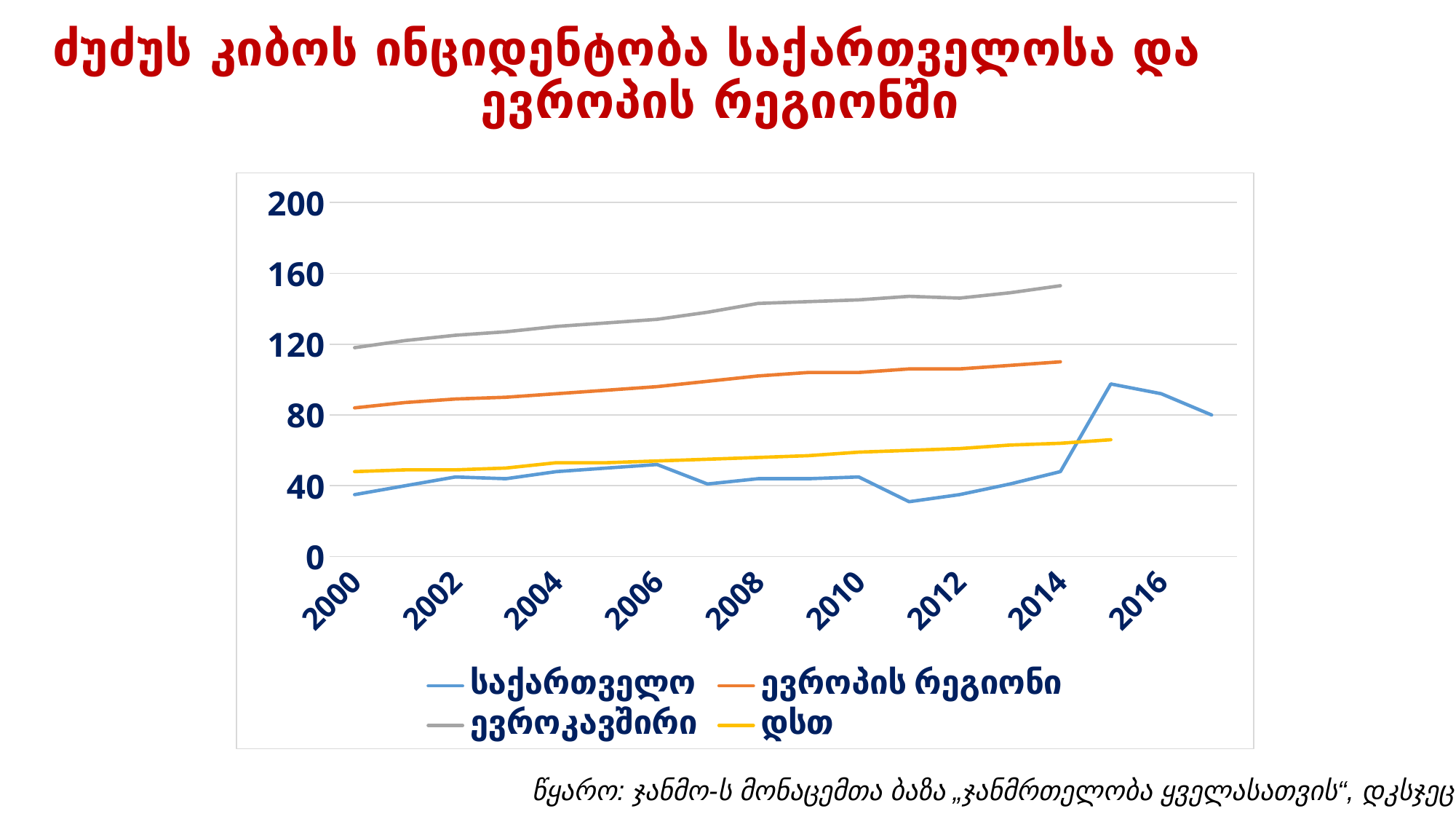
In 2010, which is higher: ევროკავშირი or ევროპის რეგიონი? ევროკავშირი Which series does the legend list in blue? საქართველო Is the value for საქართველო in 2011 greater or less than 40? less What kind of chart is shown on the slide? line chart What is the title of the slide? ძუძუს კიბოს ინციდენტობა საქართველოსა და ევროპის რეგიონში Is the value for ევროპის რეგიონი in 2014 greater or less than 120? less In 2015, which is higher: საქართველო or დსთ? საქართველო How many series does the legend list? 4 Which series has the highest values across the whole period? ევროკავშირი